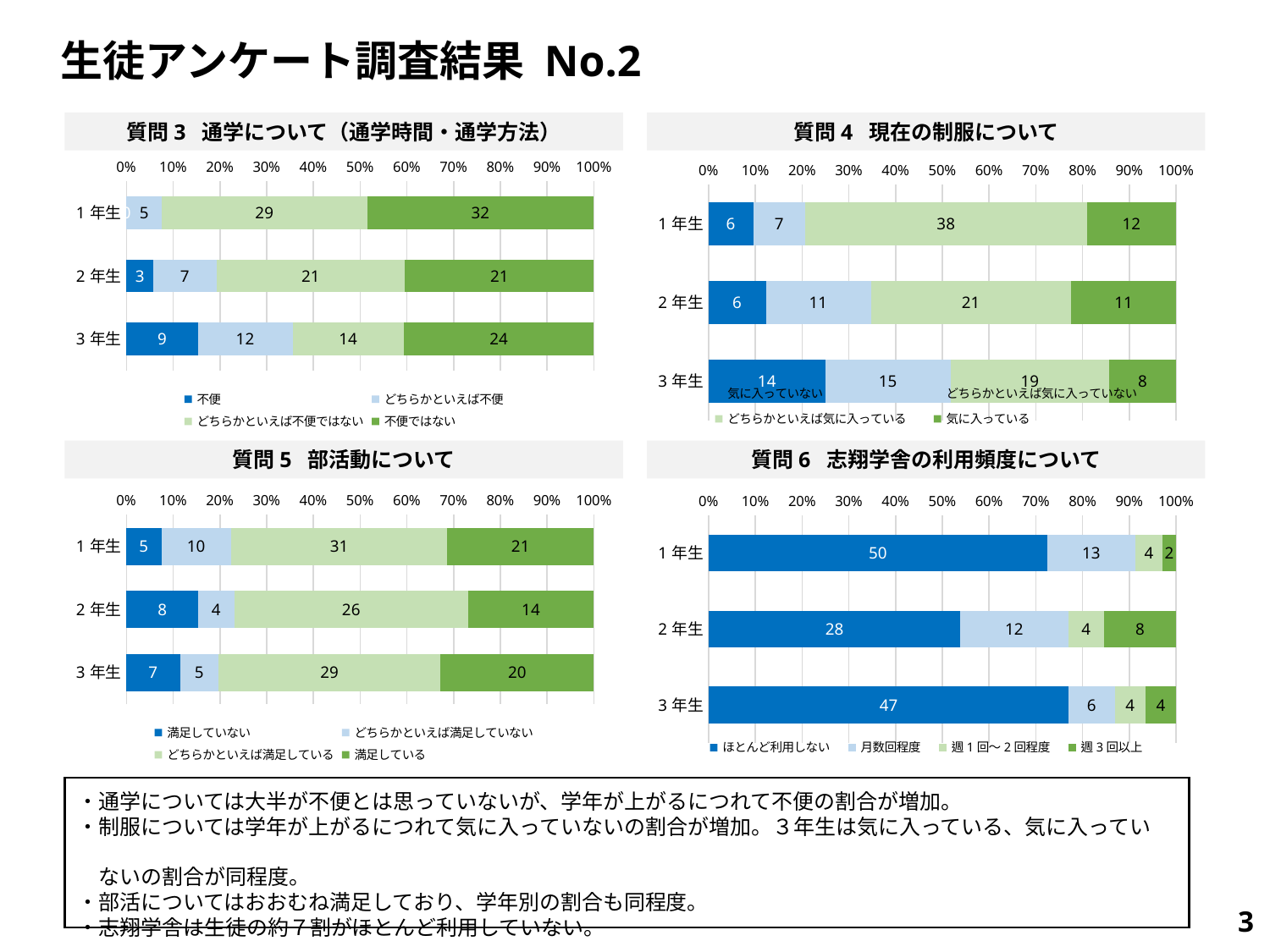
In the 質問3 通学について chart, what is the value of 不便ではない for 1年生? 32 In the 質問5 部活動について chart, what is the value of 満足している for 2年生? 14 In the 質問4 現在の制服について chart, what is the difference between 気に入っていない for 3年生 and for 1年生? 8 In the 質問6 志翔学舎の利用頻度について chart, what is the value of ほとんど利用しない for 1年生? 50 What kind of chart is the 質問5 部活動について chart? Stacked bar chart In the 質問4 現在の制服について chart, what is the value of どちらかといえば気に入っている for 1年生? 38 In the 質問6 志翔学舎の利用頻度について chart, which grade has the lowest value for ほとんど利用しない? 2年生 In the 質問4 現在の制服について chart, what is the total of the 3年生 bar? 56 In the 質問3 通学について chart, which grade has the highest value for 不便? 3年生 In the 質問5 部活動について chart, which is larger for 3年生: 満足していない or どちらかといえば満足していない? 満足していない In the 質問6 志翔学舎の利用頻度について chart, what is the total of the 1年生 bar? 69 How many series does the legend of the 質問6 志翔学舎の利用頻度について chart list? 4